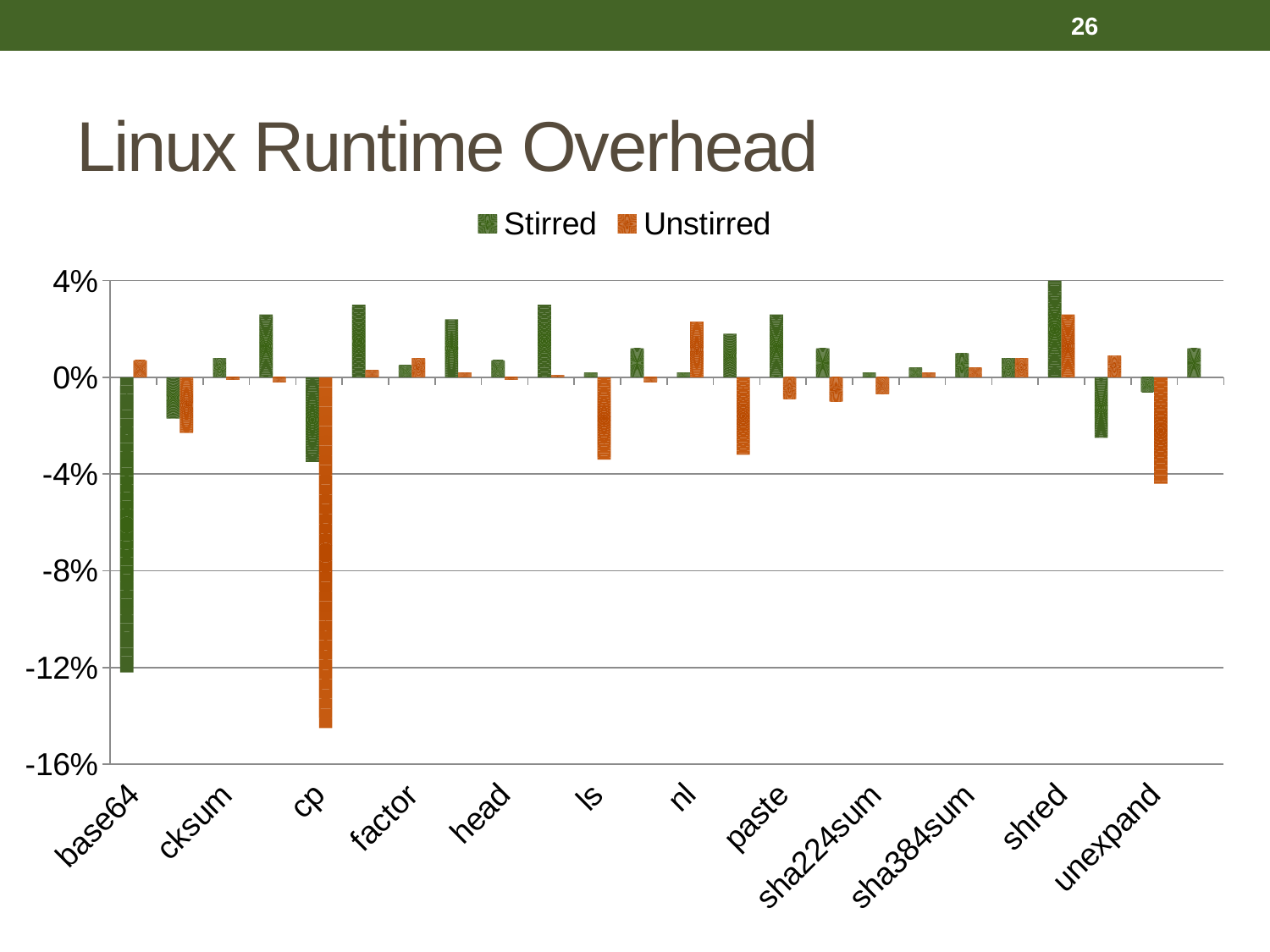
Which category has the lowest Unstirred value? cp Is the Stirred value for base64 greater or less than -8%? less How many series does the legend list? 2 What kind of chart is shown on the slide? Bar chart Is the Unstirred value for cp greater or less than -12%? less What are the two series named in the legend? Stirred and Unstirred Which category has the highest Stirred value? shred For base64, which is larger, the Stirred value or the Unstirred value? Unstirred For cp, which is larger, the Stirred value or the Unstirred value? Stirred Is the Unstirred value for unexpand greater or less than -2%? less Which colour represents the Unstirred series? Orange Which category has the lowest Stirred value? base64